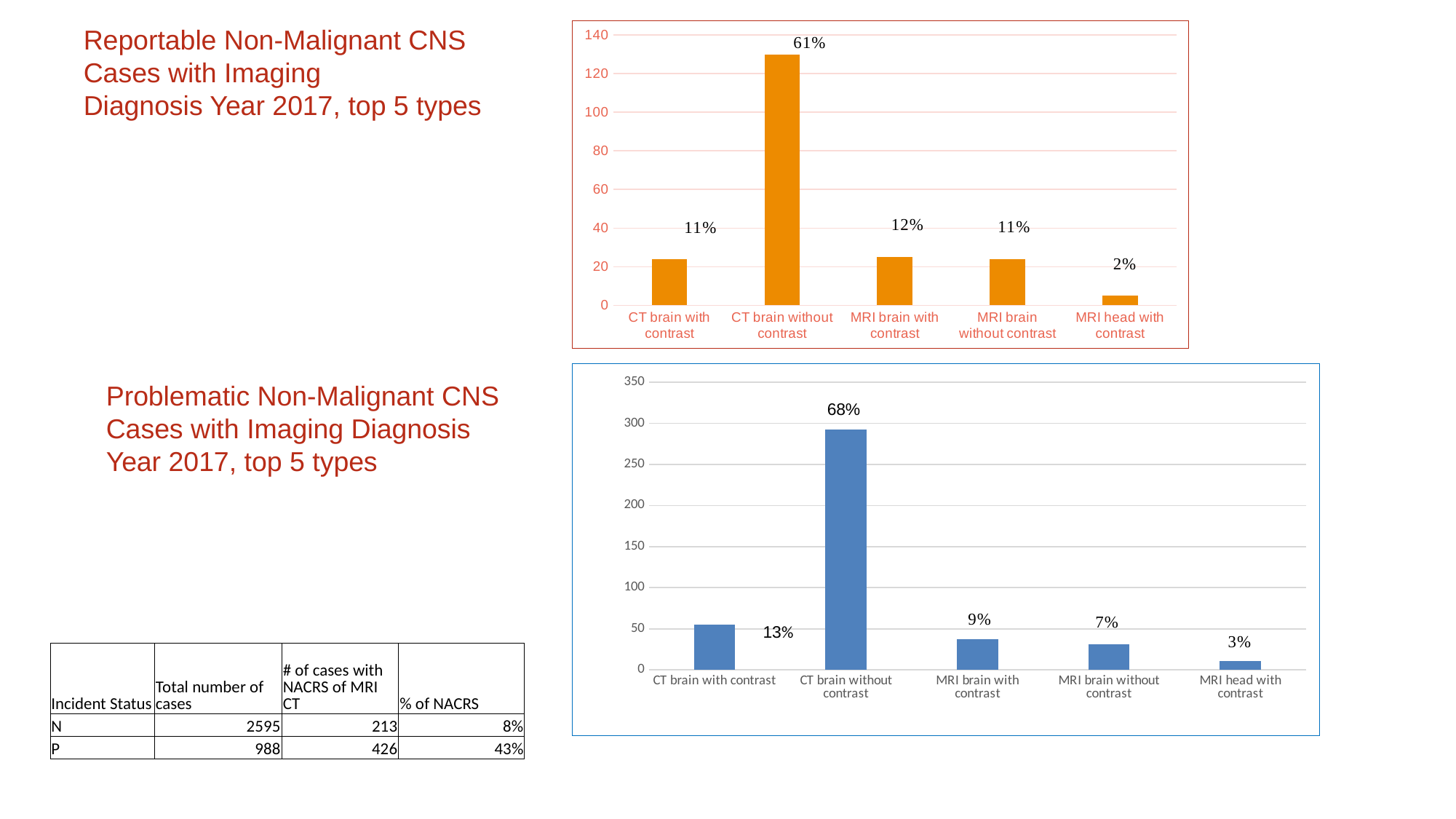
In the top chart (Reportable Non-Malignant CNS Cases), what percentage label is shown for CT brain without contrast? 61% In the bottom chart (Problematic Non-Malignant CNS Cases), what percentage label is shown for CT brain with contrast? 13% In the top chart (Reportable Non-Malignant CNS Cases), which is larger: the bar for MRI brain with contrast or the bar for MRI head with contrast? MRI brain with contrast In the bottom chart (Problematic Non-Malignant CNS Cases), is the bar for MRI brain with contrast greater or less than 50? less What kind of chart is the top chart (Reportable Non-Malignant CNS Cases)? Bar chart In the top chart (Reportable Non-Malignant CNS Cases), which imaging type has the highest bar? CT brain without contrast How many imaging types are shown in the bottom chart (Problematic Non-Malignant CNS Cases)? 5 In the bottom chart (Problematic Non-Malignant CNS Cases), what percentage label is shown for MRI brain without contrast? 7% In the top chart (Reportable Non-Malignant CNS Cases), is the bar for CT brain without contrast greater or less than 120? greater In the bottom chart (Problematic Non-Malignant CNS Cases), which imaging type has the lowest bar? MRI head with contrast In the top chart (Reportable Non-Malignant CNS Cases), what percentage label is shown for MRI head with contrast? 2% In the bottom chart (Problematic Non-Malignant CNS Cases), is the bar for CT brain without contrast greater or less than 250? greater